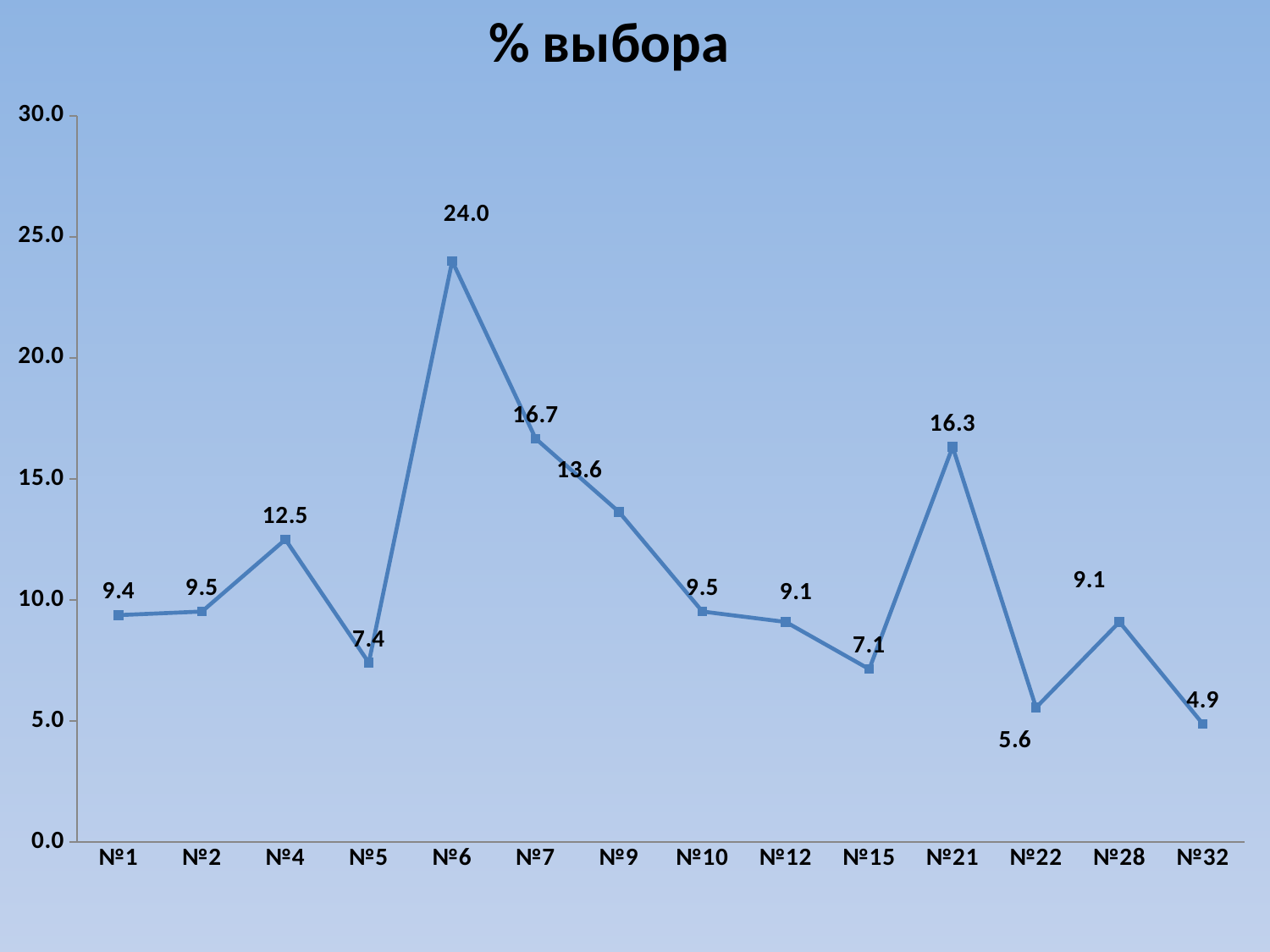
What is the title of the chart? % выбора How many categories are plotted on the x axis? 14 What is the value for №32? 4.9 What kind of chart is shown on the slide? line chart Which category has the highest value? №6 What is the difference between the values for №21 and №22? 10.7 Which category has the lowest value? №32 Which is larger, the value for №4 or the value for №9? №9 What is the value for №21? 16.3 What is the difference between the values for №6 and №7? 7.3 What is the value for №6? 24.0 Is the value for №6 greater or less than 20.0? greater